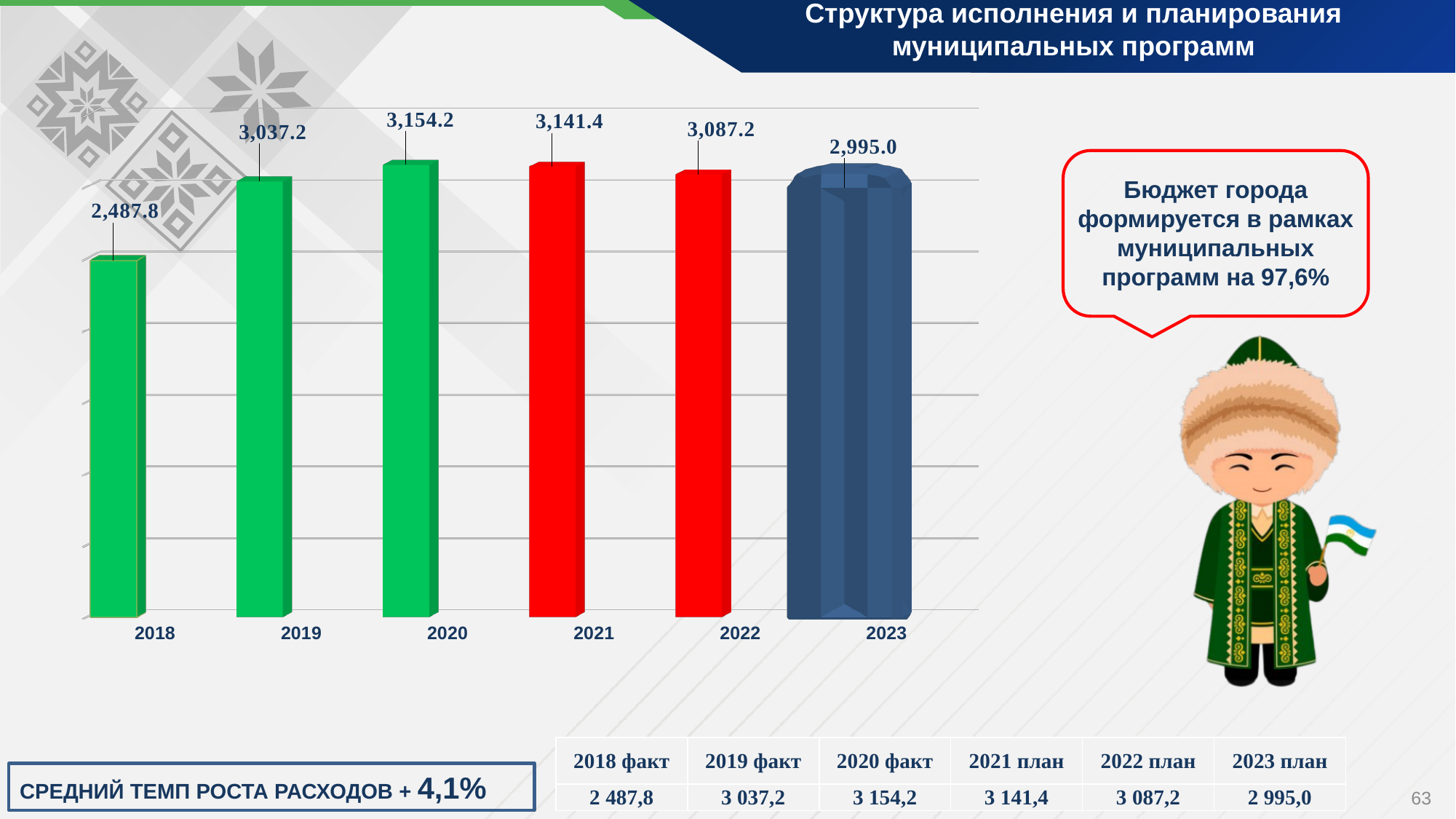
What is the value shown for 2018? 2,487.8 How many years are shown on the x axis? 6 Which year has the highest value? 2020 Which is larger, the value for 2019 or the value for 2022? 2022 What is the difference between the values for 2020 and 2018? 666.4 Which year has the lowest value? 2018 Do the values rise or fall from 2020 to 2023? fall What colour are the bars for 2021 and 2022? red What is the value shown for 2021? 3,141.4 What is the value shown for 2023? 2,995.0 What kind of chart is this? bar chart What is the difference between the values for 2021 and 2022? 54.2